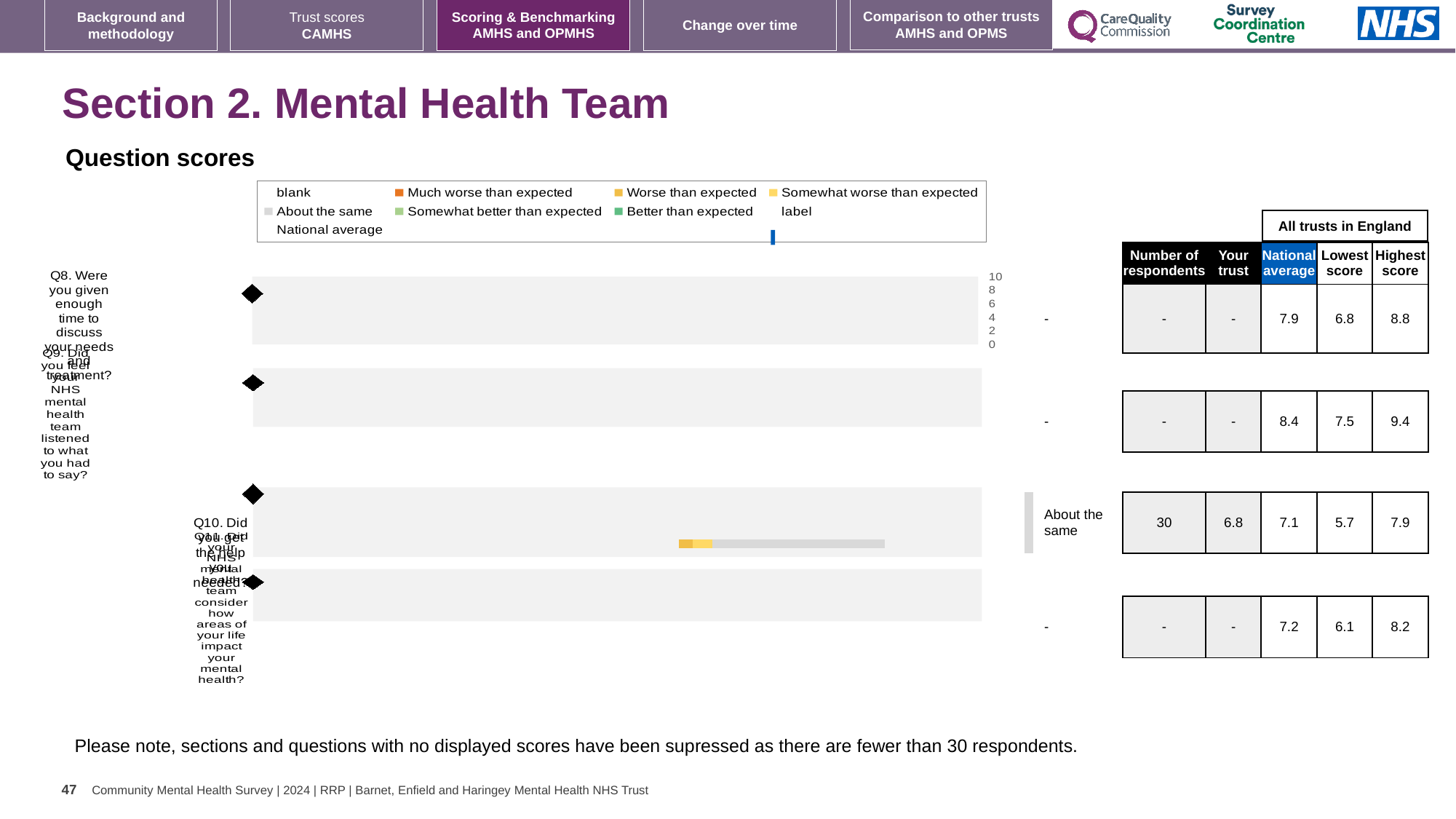
What is the 'Your trust' score for Q10 in the table? 6.8 What kind of chart is shown under 'Question scores'? bar chart What benchmark label is shown next to the Q10 bar? About the same What is the difference between the highest score and the lowest score for Q10? 2.2 What is the national average for Q10? 7.1 Which question has the highest national average in the table? Q9 In the table next to the chart, what is the number of respondents for Q10? 30 For Q10, which is larger: the 'Your trust' score or the national average? National average What is the national average for Q8? 7.9 What is the lowest score across all trusts in England for Q11? 6.1 How many questions (categories) are plotted in the Question scores chart? 4 What is the highest score across all trusts in England for Q9? 9.4